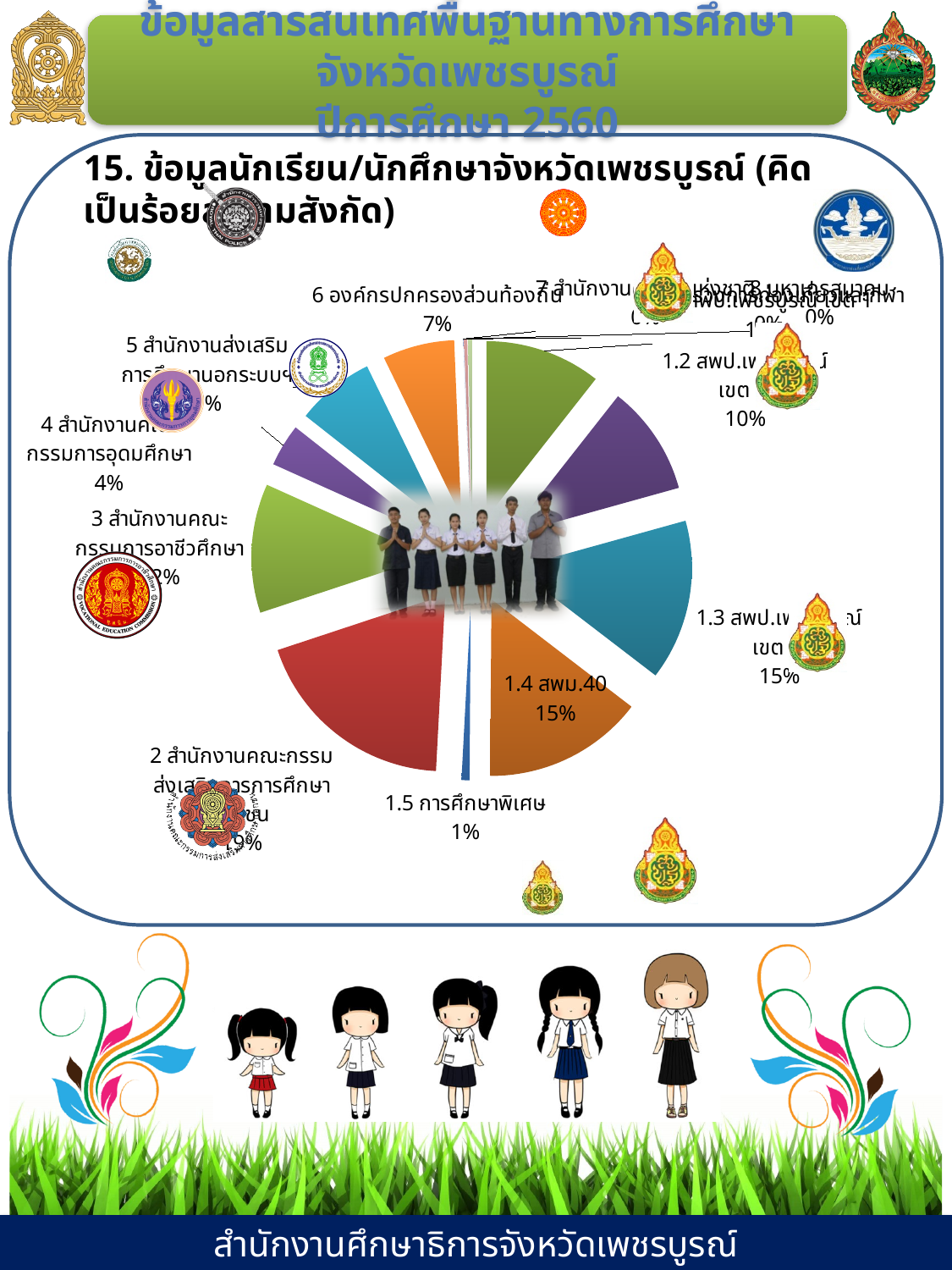
Which academic year does the slide's data refer to? ปีการศึกษา 2560 What is the difference in percentage points between 1.4 สพม.40 and 1.5 การศึกษาพิเศษ? 14 What percentage is shown for 6 องค์กรปกครองส่วนท้องถิ่น? 7% What percentage is shown for 1.5 การศึกษาพิเศษ? 1% What is the number of the section heading above the chart? 15 What percentage is shown for 1.4 สพม.40? 15% What kind of chart is shown on the slide? pie chart Which has a larger share, 1.4 สพม.40 or 1.5 การศึกษาพิเศษ? 1.4 สพม.40 Which has a larger share, 6 องค์กรปกครองส่วนท้องถิ่น or 4 สำนักงานคณะกรรมการอุดมศึกษา? 6 องค์กรปกครองส่วนท้องถิ่น What is the difference in percentage points between 6 องค์กรปกครองส่วนท้องถิ่น and 4 สำนักงานคณะกรรมการอุดมศึกษา? 3 What percentage is shown for 4 สำนักงานคณะกรรมการอุดมศึกษา? 4% What is the largest percentage shown on the pie chart? 19%